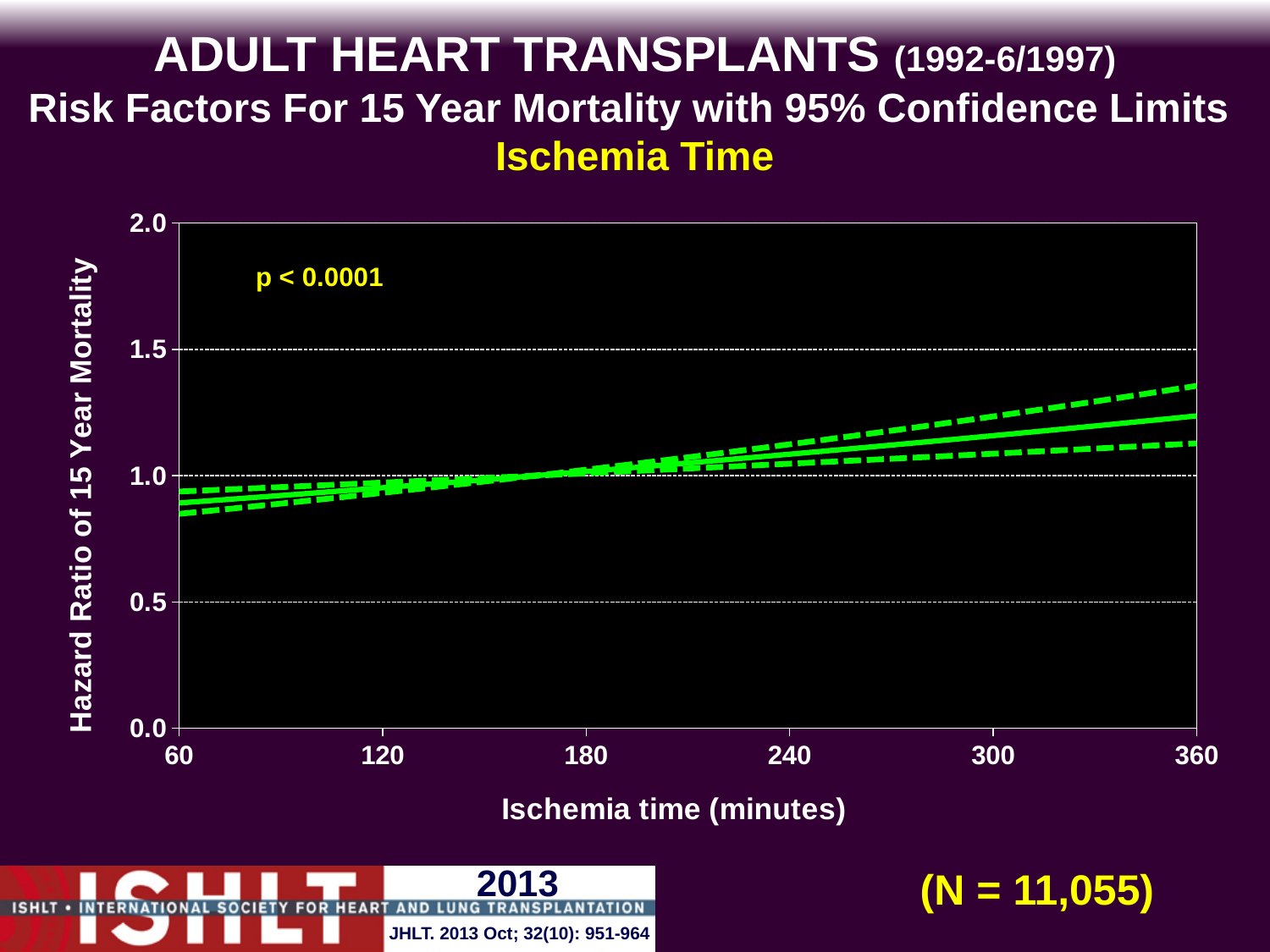
What is the highest value labelled on the y axis? 2.0 Is the hazard ratio at an ischemia time of 60 minutes greater or less than 1.0? less What is the range of ischemia time shown on the x axis? 60 to 360 minutes What p-value is printed on the chart? p < 0.0001 Which ischemia time has the larger hazard ratio, 60 minutes or 360 minutes? 360 minutes What is the sample size (N) shown on the slide? N = 11,055 How many tick labels are shown on the x axis? 6 Is the upper 95% confidence limit at 360 minutes greater or less than 1.5? less Is the hazard ratio at an ischemia time of 360 minutes greater or less than 1.0? greater Does the hazard ratio of 15 year mortality rise or fall as ischemia time increases from 60 to 360 minutes? rise How many lines (estimate plus confidence limits) are plotted on the chart? 3 What kind of chart is shown on the slide? line chart